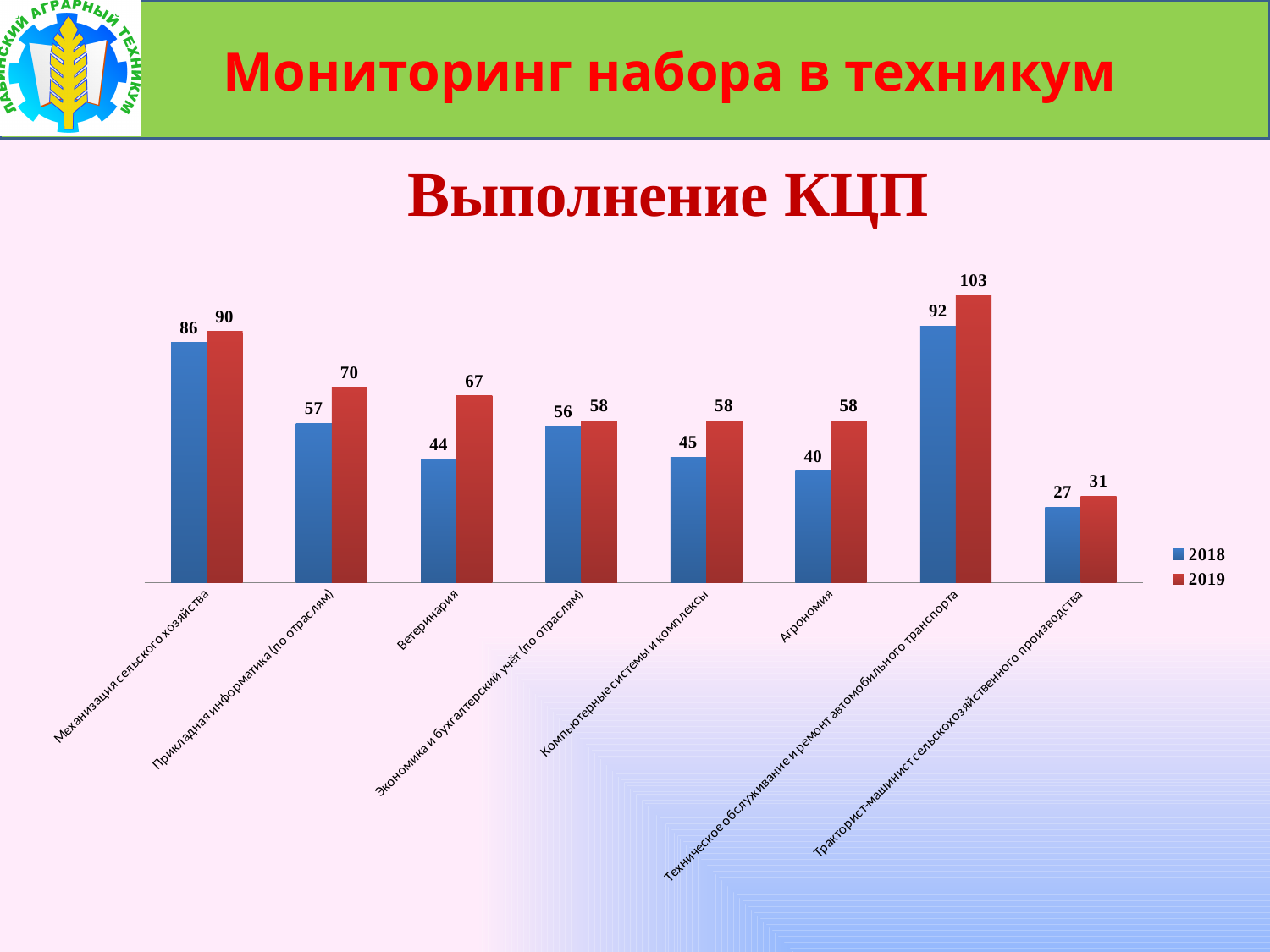
What is the 2018 value for Агрономия? 40 Which category has the lowest 2019 value? Тракторист-машинист сельскохозяйственного производства What is the 2019 value for Техническое обслуживание и ремонт автомобильного транспорта? 103 How many categories are shown on the x axis of the chart? 8 Which is larger: the 2018 value for Механизация сельского хозяйства or the 2018 value for Техническое обслуживание и ремонт автомобильного транспорта? Техническое обслуживание и ремонт автомобильного транспорта What is the 2019 value for Ветеринария? 67 Which category has the highest 2018 value? Техническое обслуживание и ремонт автомобильного транспорта How many series does the legend list? 2 What is the title of the chart? Выполнение КЦП What is the difference between the 2019 and 2018 values for Прикладная информатика (по отраслям)? 13 What kind of chart is shown on the slide? Bar chart What is the difference between the 2019 and 2018 values for Ветеринария? 23